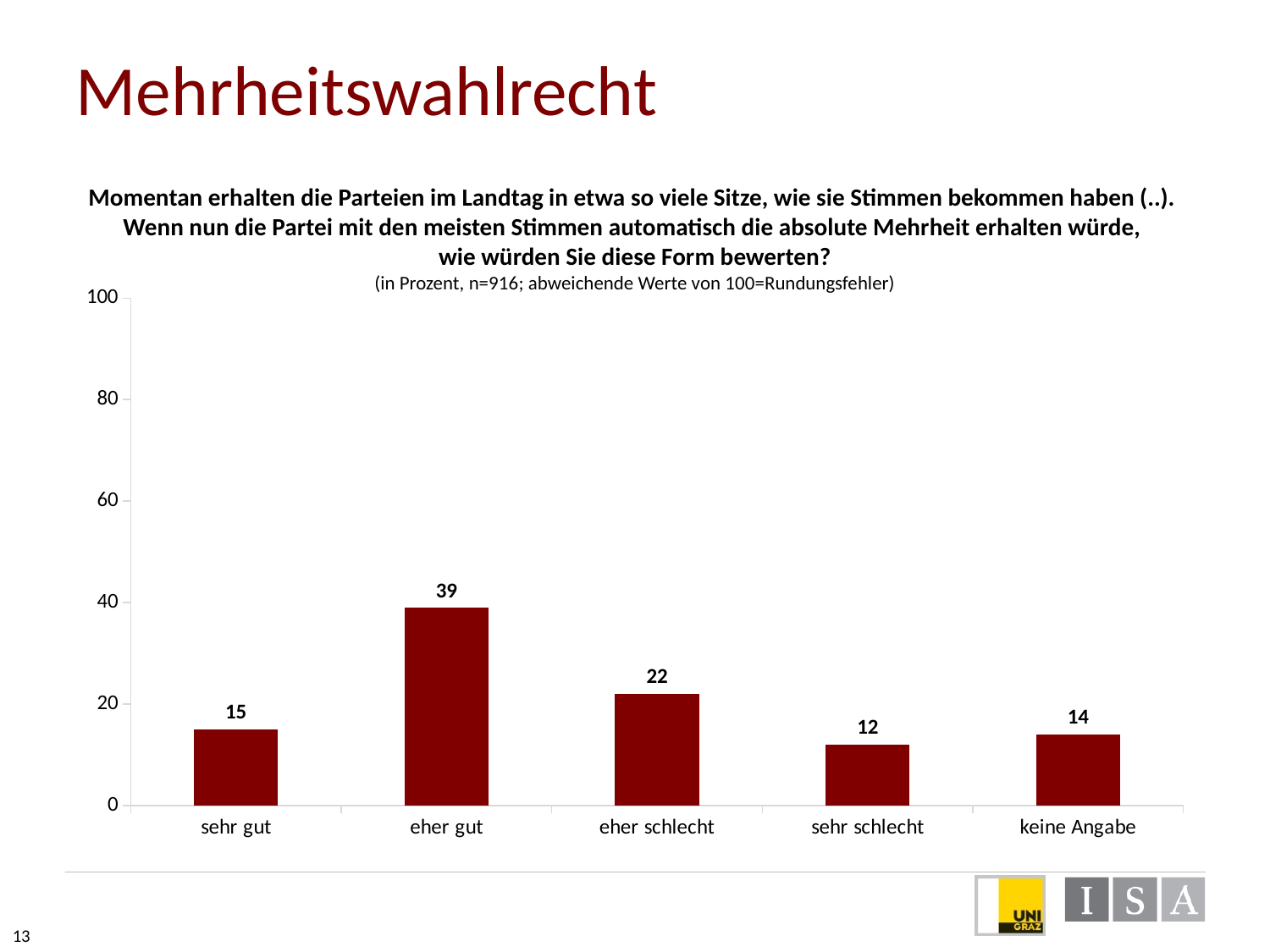
What is the value for "keine Angabe"? 14 What is the value for "sehr schlecht"? 12 Which category has the lowest value? sehr schlecht What is the value for "eher gut"? 39 What is the highest tick value shown on the y axis? 100 How many categories are shown on the x axis? 5 What is the difference between the values for "eher gut" and "eher schlecht"? 17 Which category has the highest value? eher gut Is the value for "eher gut" greater or less than 40? less What kind of chart is shown on the slide? bar chart What is the sample size (n) stated in the chart subtitle? 916 Which is larger, the value for "sehr gut" or the value for "eher schlecht"? eher schlecht